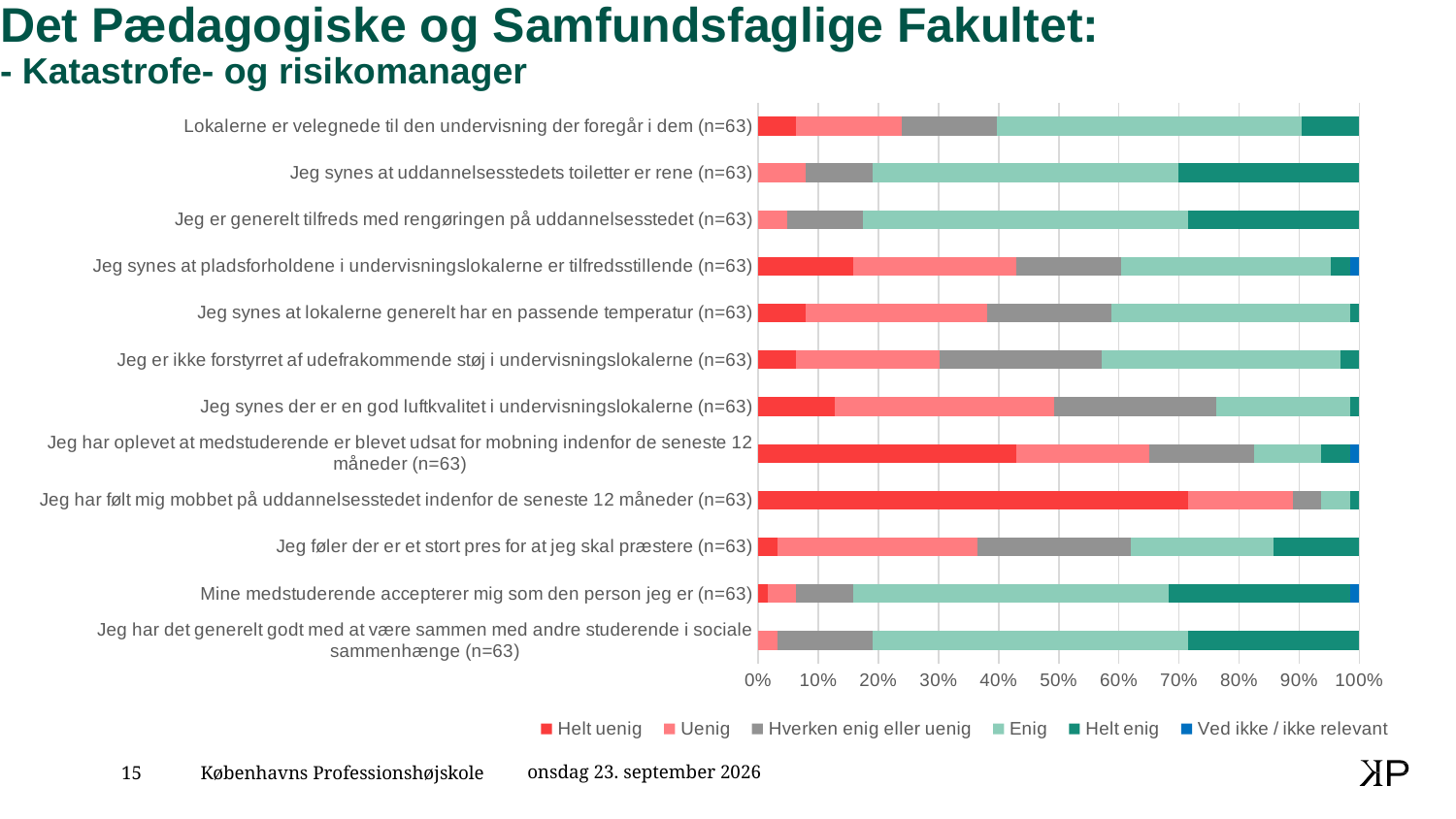
Which statement has the largest 'Helt uenig' share? Jeg har følt mig mobbet på uddannelsesstedet indenfor de seneste 12 måneder (n=63) Which has a larger 'Helt uenig' share: 'Jeg har følt mig mobbet på uddannelsesstedet indenfor de seneste 12 måneder' or 'Jeg føler der er et stort pres for at jeg skal præstere'? Jeg har følt mig mobbet på uddannelsesstedet indenfor de seneste 12 måneder How many series does the legend list? 6 Is the 'Helt uenig' share for 'Jeg har oplevet at medstuderende er blevet udsat for mobning indenfor de seneste 12 måneder' greater or less than 50%? less Which response category is listed first in the legend? Helt uenig Is the 'Helt enig' share for 'Jeg synes at uddannelsesstedets toiletter er rene' greater or less than 20%? greater Is the 'Helt uenig' share for 'Jeg har følt mig mobbet på uddannelsesstedet indenfor de seneste 12 måneder' greater or less than 50%? greater What is the sample size (n) shown for each statement in the chart? 63 What kind of chart is shown on the slide? Stacked bar chart How many statements (categories) are plotted in the chart? 12